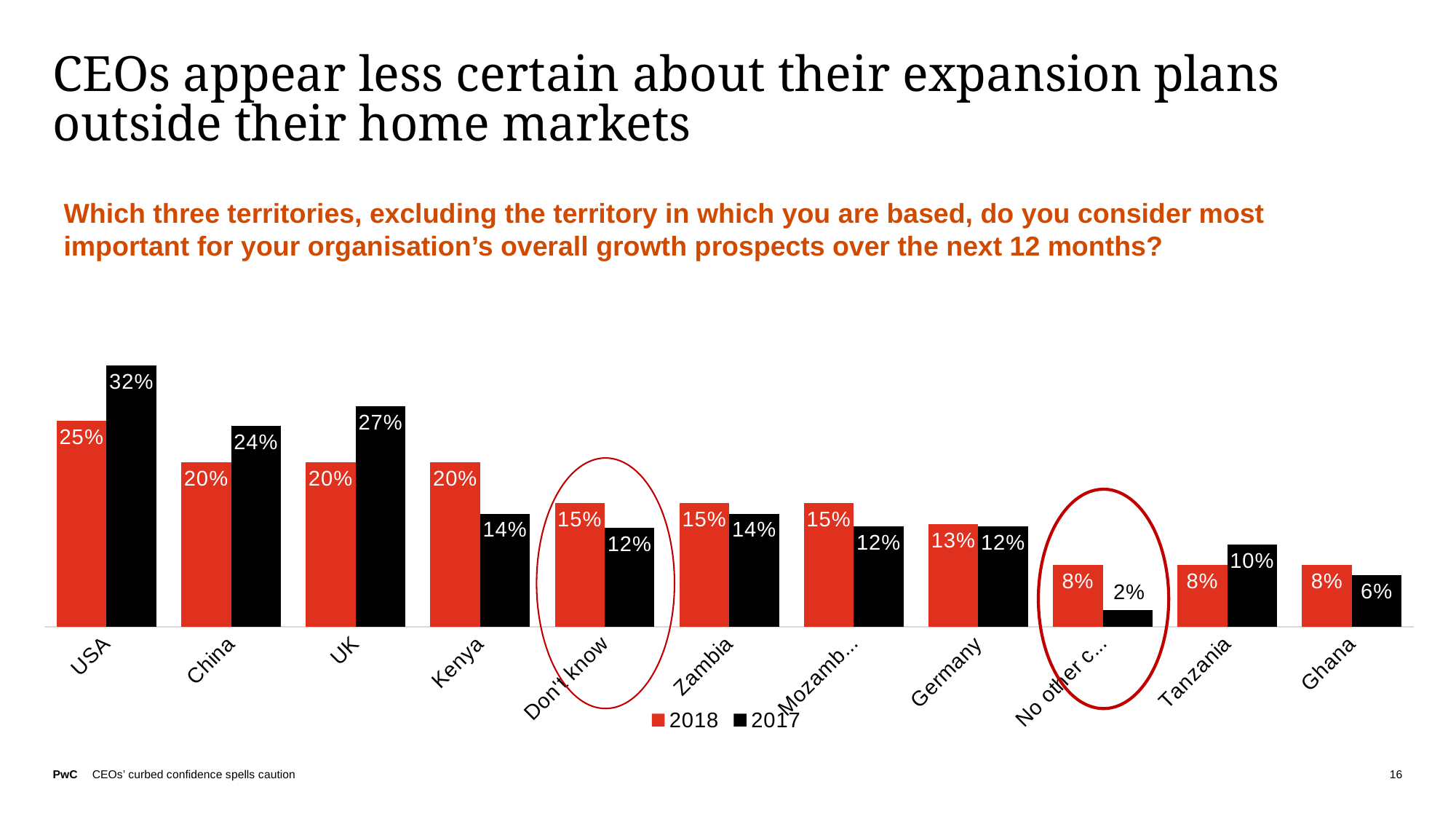
What kind of chart is shown on the slide? Bar chart What is the difference between the 2017 and 2018 values for the USA? 7% How many series does the legend list? 2 What is the 2018 value for Germany? 13% Which category has the lowest 2017 value? No other c... What is the 2017 value for the UK? 27% Which category has the highest 2017 value? USA Which colour represents the 2018 series in the legend? Red What is the 2017 value for Kenya? 14% Which is larger for Tanzania, the 2018 value or the 2017 value? 2017 What is the 2018 value for the USA? 25% How many categories are shown on the x axis? 11